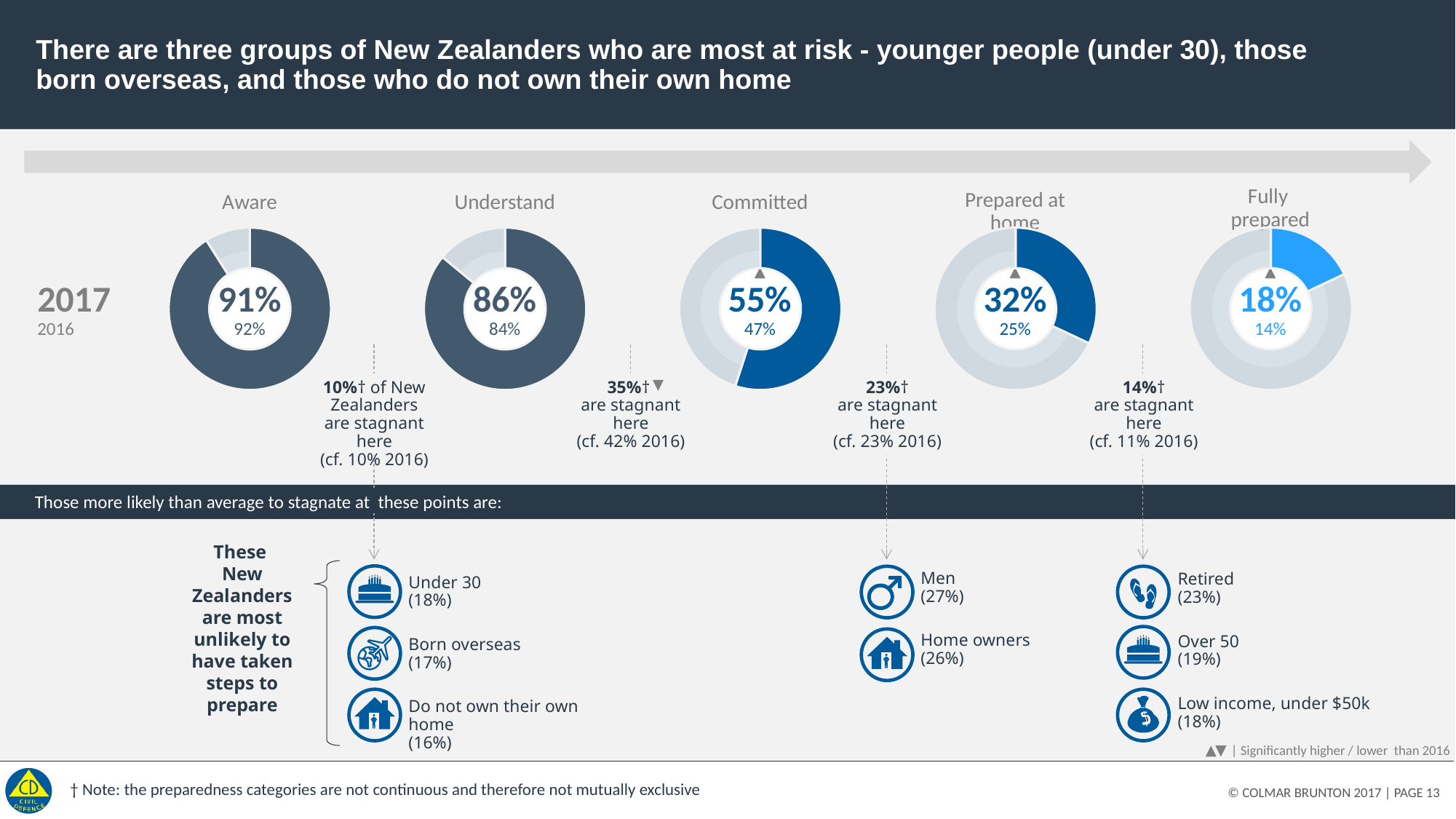
In the 'Committed' donut chart, what was the 2016 value? 47% In the 'Prepared at home' donut chart, what was the 2016 value? 25% Is the 2017 value in the 'Understand' donut chart larger or smaller than the 2017 value in the 'Committed' donut chart? larger Across the five donut charts, which stage has the highest 2017 value? Aware What kind of chart is used to show the 2017 percentages for each preparedness stage? Donut (pie) chart In the 'Fully prepared' donut chart, what is the 2017 value? 18% In the 'Aware' donut chart, what is the 2017 value? 91% How many donut charts are shown on the slide? 5 Across the five donut charts, which stage has the lowest 2017 value? Fully prepared In the 'Prepared at home' donut chart, what is the difference between the 2017 and 2016 values? 7 percentage points Do the 2017 values fall or rise moving from 'Aware' to 'Fully prepared' across the donut charts? fall In the 'Committed' donut chart, what is the difference between the 2017 and 2016 values? 8 percentage points